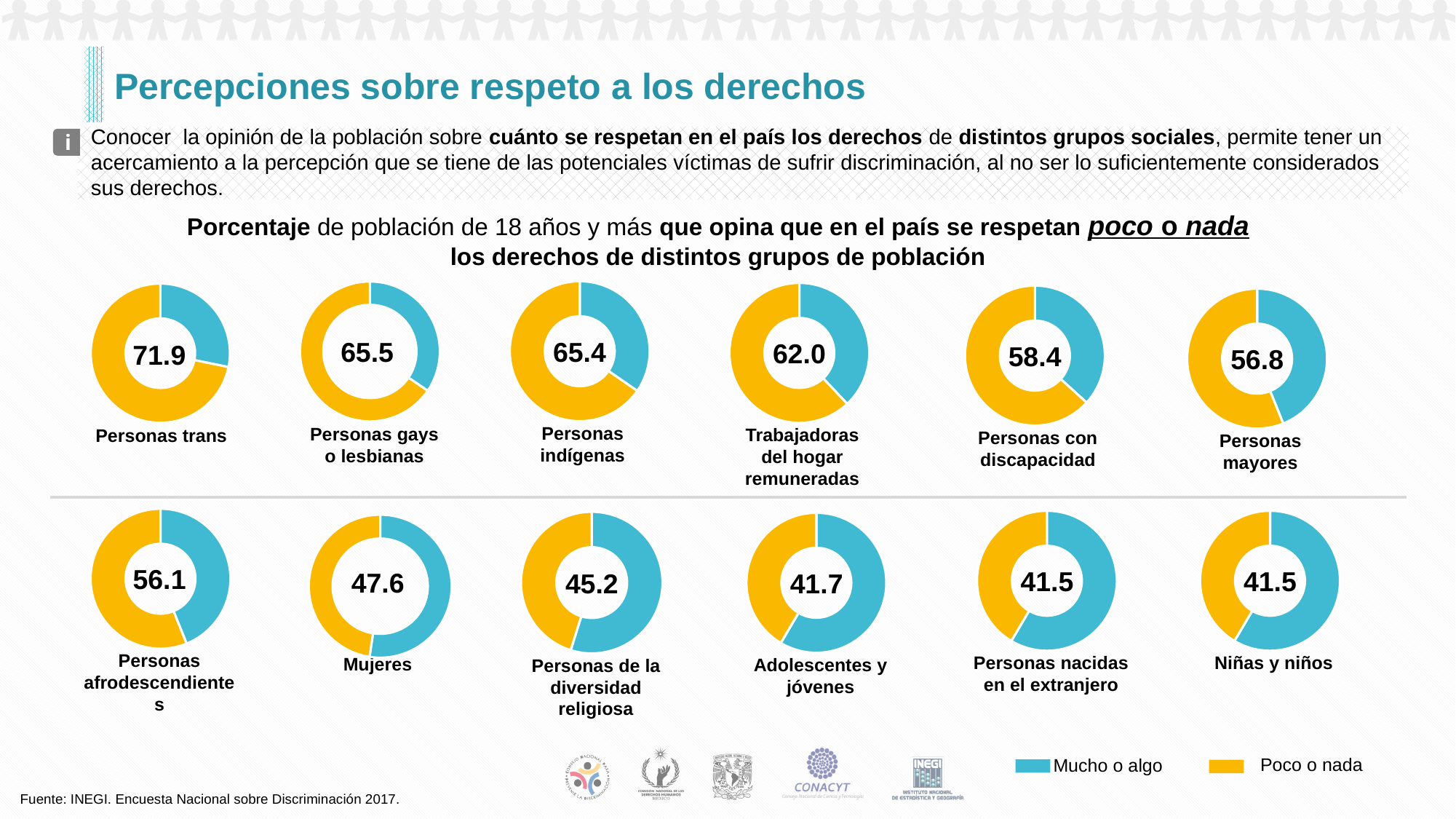
What percentage is shown in the donut chart for Personas trans? 71.9 Which two groups share the lowest value, 41.5, across the donut charts? Personas nacidas en el extranjero and Niñas y niños What is the difference between the values for Personas trans and Mujeres? 24.3 What is the difference between the values for Personas con discapacidad and Personas mayores? 1.6 What value is shown in the donut chart for Trabajadoras del hogar remuneradas? 62.0 What value is shown in the donut chart for Mujeres? 47.6 Which group has the highest percentage of people who think its rights are respected 'poco o nada'? Personas trans Which is larger, the value for Personas indígenas or the value for Personas afrodescendientes? Personas indígenas What kind of charts are used on the slide? Donut (pie) charts How many categories does the legend at the bottom of the slide list? 2 Which colour represents 'Poco o nada' in the legend? Yellow/orange How many donut charts are shown on the slide? 12